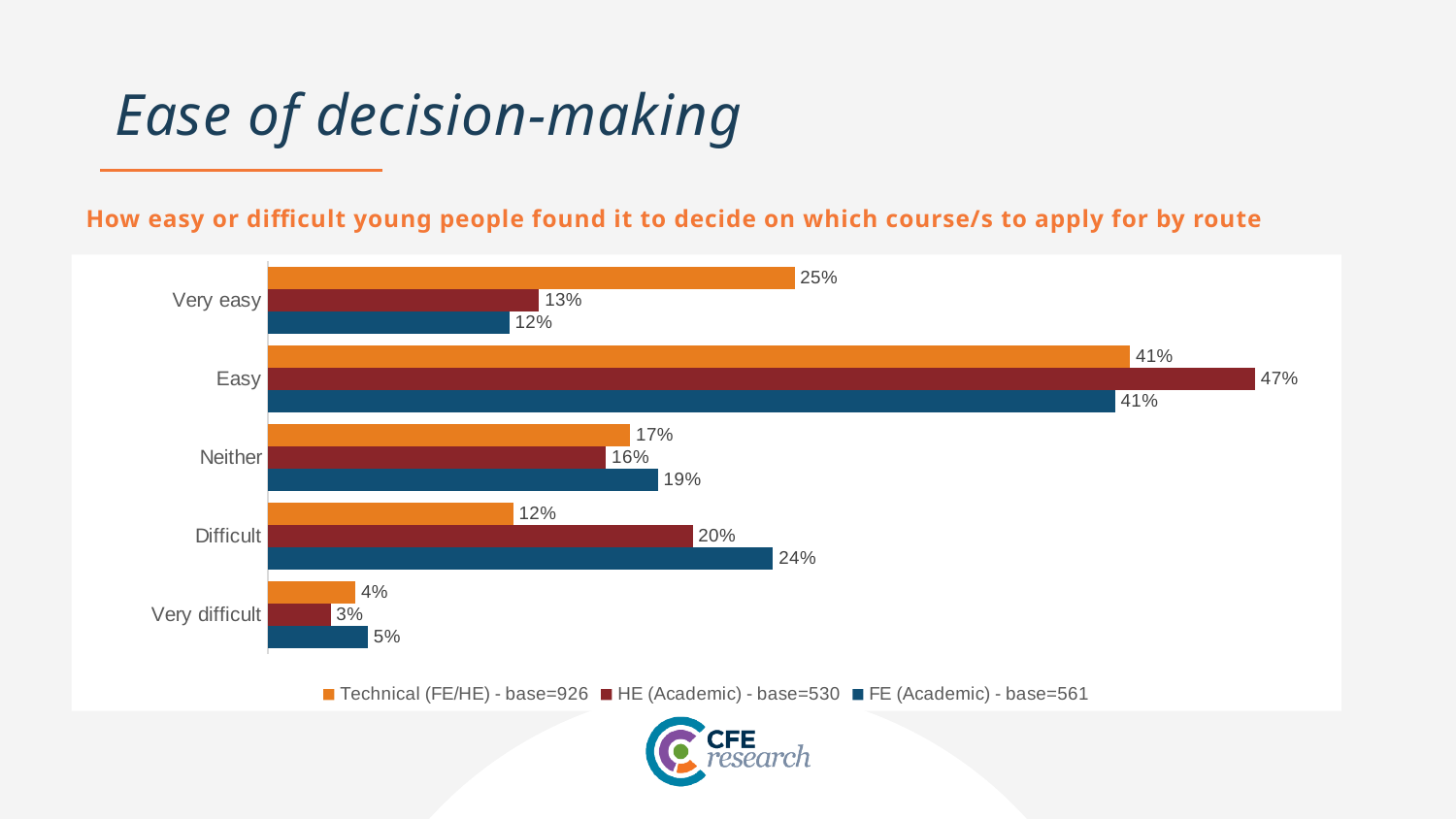
What is the base size for the FE (Academic) series according to the legend? 561 In the Difficult category, which is larger: the Technical (FE/HE) value or the HE (Academic) value? HE (Academic) What is the value for HE (Academic) in the Very difficult category? 3% Which category has the lowest value for the Technical (FE/HE) series? Very difficult What kind of chart is shown on the slide? Bar chart What is the value for HE (Academic) in the Easy category? 47% What is the difference between the Technical (FE/HE) and FE (Academic) values in the Very easy category? 13% Which category has the highest value for the HE (Academic) series? Easy What percentage of the Technical (FE/HE) group found it very easy to decide on which course/s to apply for? 25% How many categories are shown on the chart? 5 What is the value for FE (Academic) in the Difficult category? 24% How many series does the legend list? 3